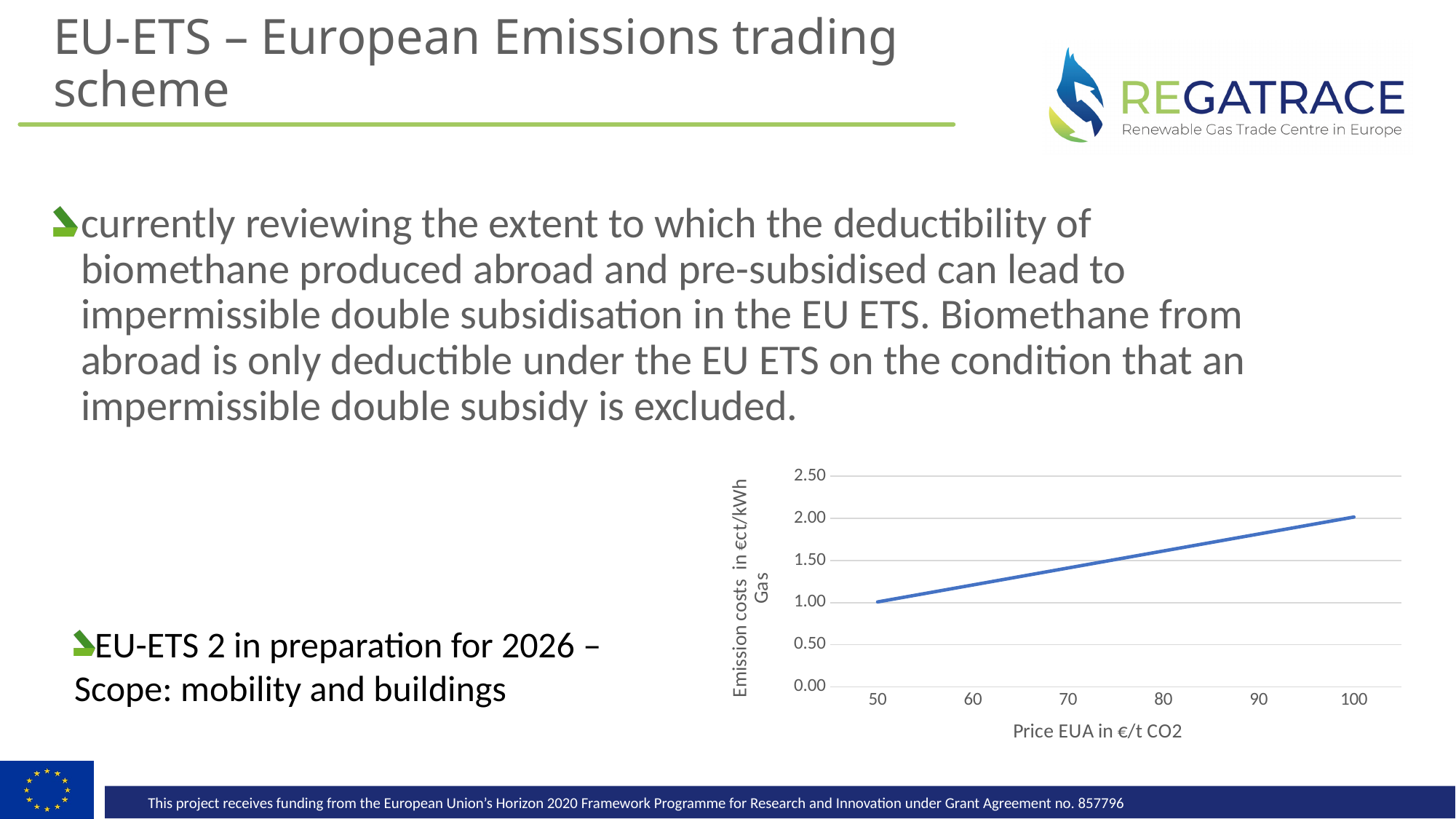
What kind of chart is shown on the slide? line chart At which EUA price shown on the x axis is the emission cost highest? 100 What is the label of the x axis of the chart? Price EUA in €/t CO2 Is the emission cost at an EUA price of 80 greater or less than 1.50? greater Is the emission cost at an EUA price of 90 greater or less than 2.00? less What is the label of the y axis of the chart? Emission costs in €ct/kWh Gas Which EUA price has the higher emission cost, 60 or 90 €/t CO2? 90 Is the emission cost at an EUA price of 70 greater or less than 1.00? greater Do the emission costs rise or fall as the EUA price increases along the x axis? rise